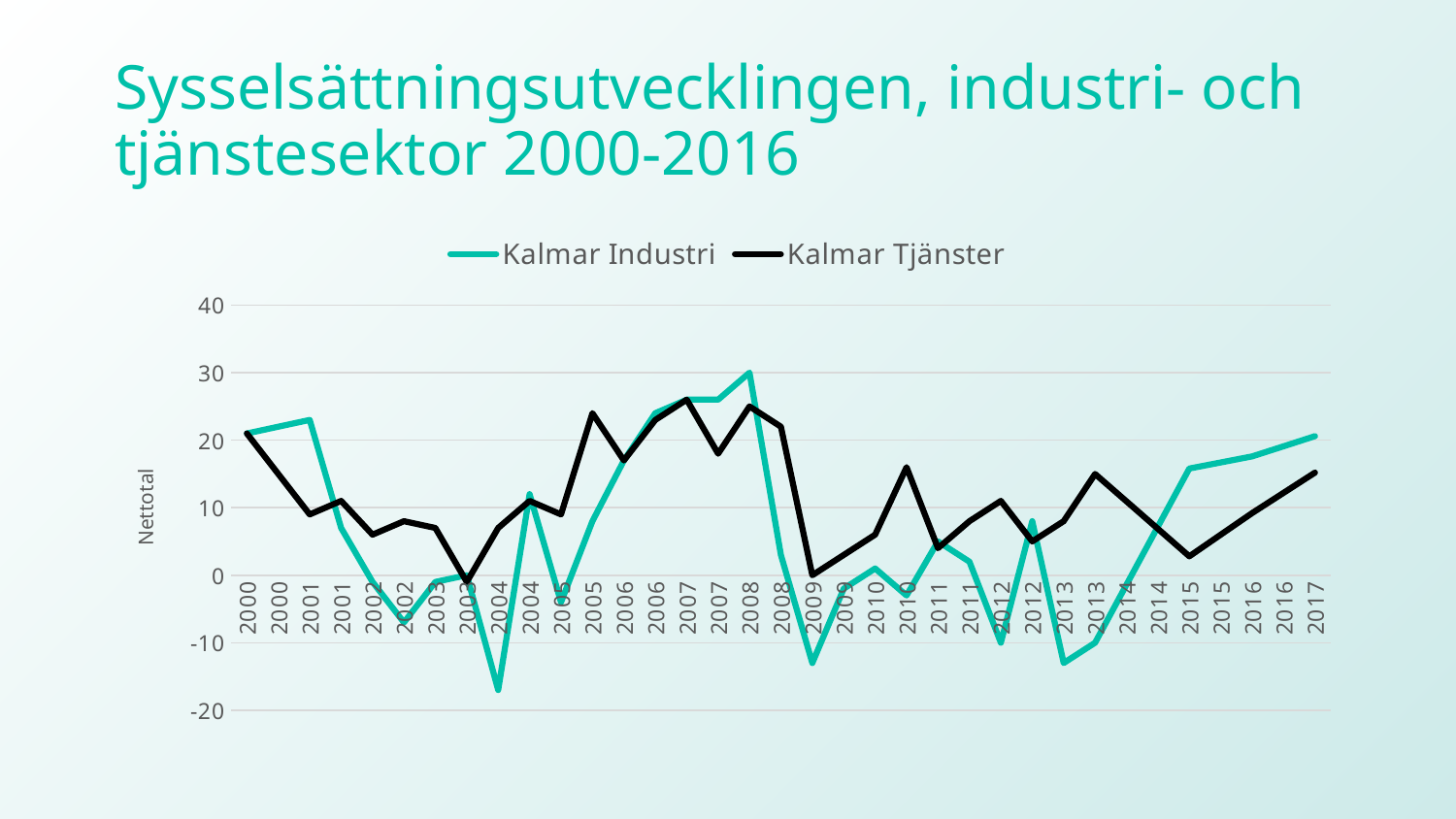
What kind of chart is shown on the slide? Line chart What is the label on the vertical axis? Nettotal Is the value for Kalmar Industri at the first 2004 point greater or less than -10? less At which x-axis point does Kalmar Industri reach its highest value? 2008 (first point) Is the value for Kalmar Tjänster at the first 2005 point greater or less than 20? less Is the value for Kalmar Industri at the first 2013 point greater or less than -10? less At the first 2013 point, which series has the larger value, Kalmar Industri or Kalmar Tjänster? Kalmar Tjänster At which x-axis point does Kalmar Industri reach its lowest value? 2004 (first point) How many series does the legend list? 2 How many points are labelled along the x axis? 35 What are the two series named in the legend? Kalmar Industri and Kalmar Tjänster